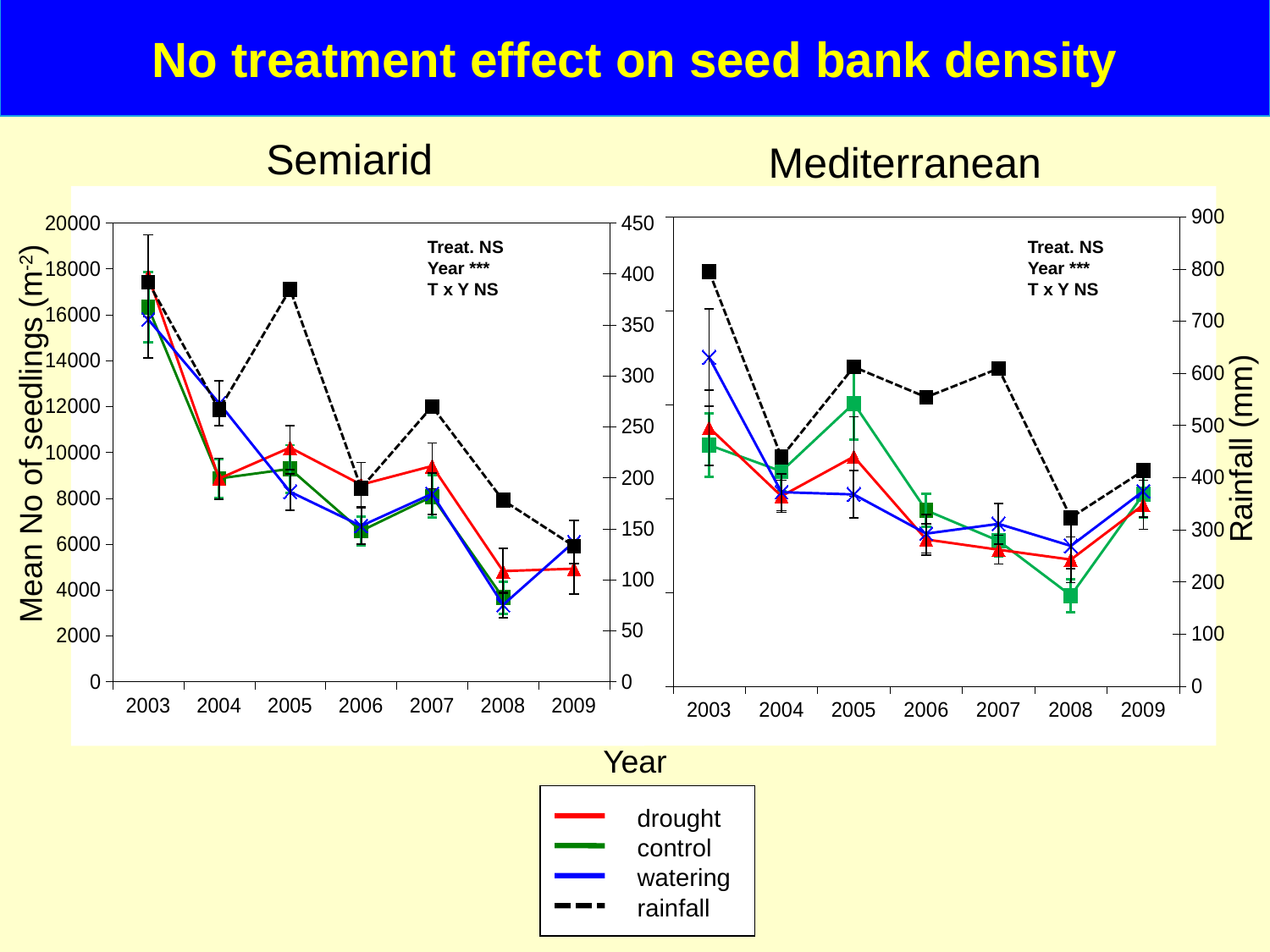
In the Mediterranean chart, do the seedling values for the control series generally rise or fall from 2003 to 2008? fall In the Mediterranean chart, which year has the lowest rainfall? 2008 In the Semiarid chart, is the rainfall value for 2003 greater or less than 350? greater In the Mediterranean chart, is the control value in 2005 greater or less than the control value in 2008? greater In the Semiarid chart, which year has the highest rainfall? 2003 How many series does the legend list? 4 How many years are plotted along the x axis of the Mediterranean chart? 7 In the Semiarid chart, is the rainfall in 2005 greater or less than the rainfall in 2006? greater What kind of chart is the Semiarid chart? line chart In the Mediterranean chart, is the rainfall value for 2004 greater or less than 500? less In the Semiarid chart, is the drought value for 2008 greater or less than 6000? less Which colour is used for the watering series in the legend? blue